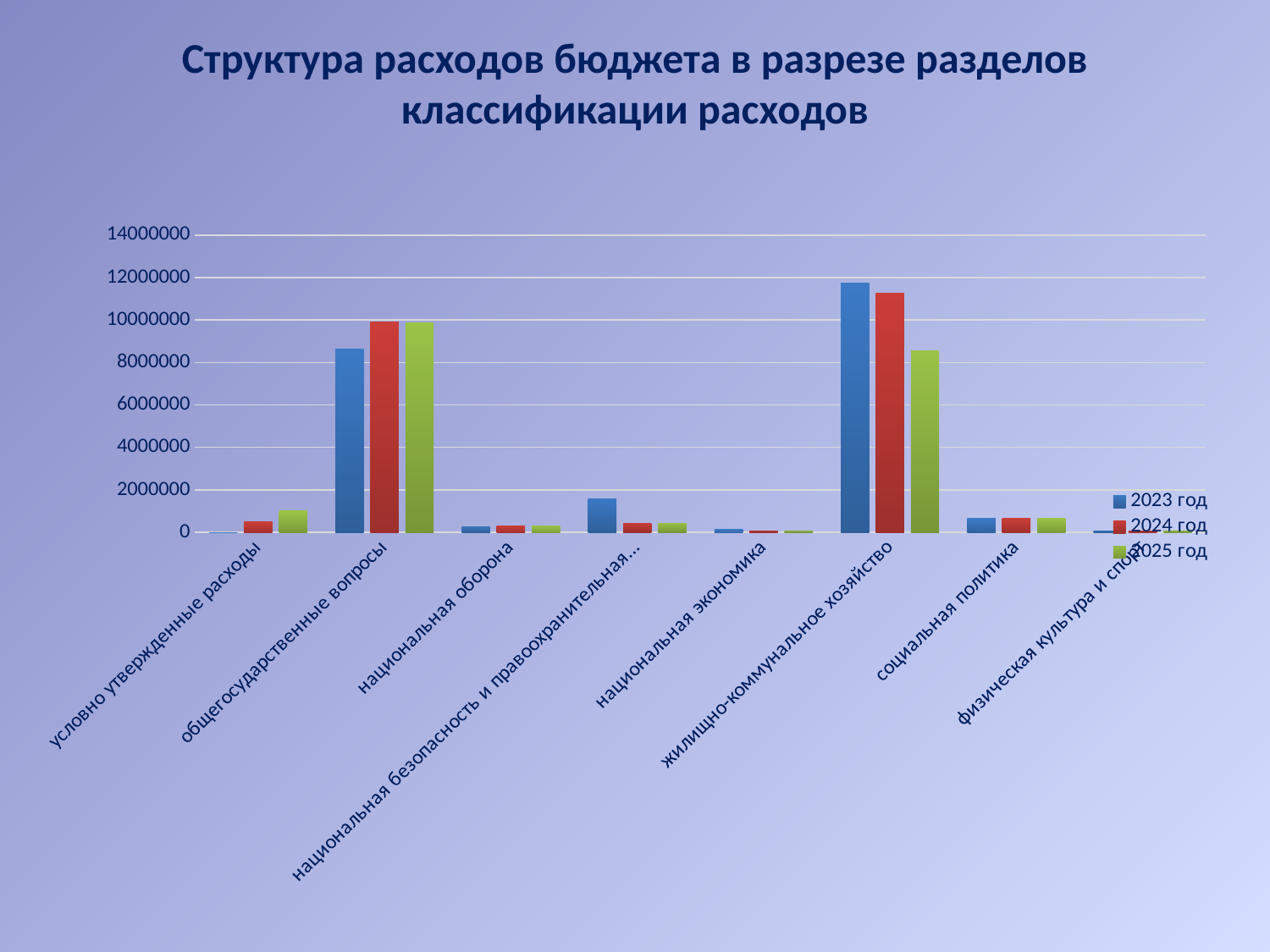
What is the title of the chart? Структура расходов бюджета в разрезе разделов классификации расходов Is the value for жилищно-коммунальное хозяйство in 2023 год greater or less than 10000000? greater For жилищно-коммунальное хозяйство, which is larger: the value for 2023 год or for 2025 год? 2023 год Is the value for жилищно-коммунальное хозяйство in 2025 год greater or less than 10000000? less Is the value for общегосударственные вопросы in 2023 год greater or less than 8000000? greater Which category has the highest value for 2025 год? общегосударственные вопросы How many series does the legend list? 3 For национальная безопасность и правоохранительная..., which is larger: the value for 2023 год or for 2024 год? 2023 год What kind of chart is shown on the slide? bar chart Which category has the highest value for 2023 год? жилищно-коммунальное хозяйство How many categories are shown on the x axis? 8 Do the values for жилищно-коммунальное хозяйство rise or fall from 2023 год to 2025 год? fall